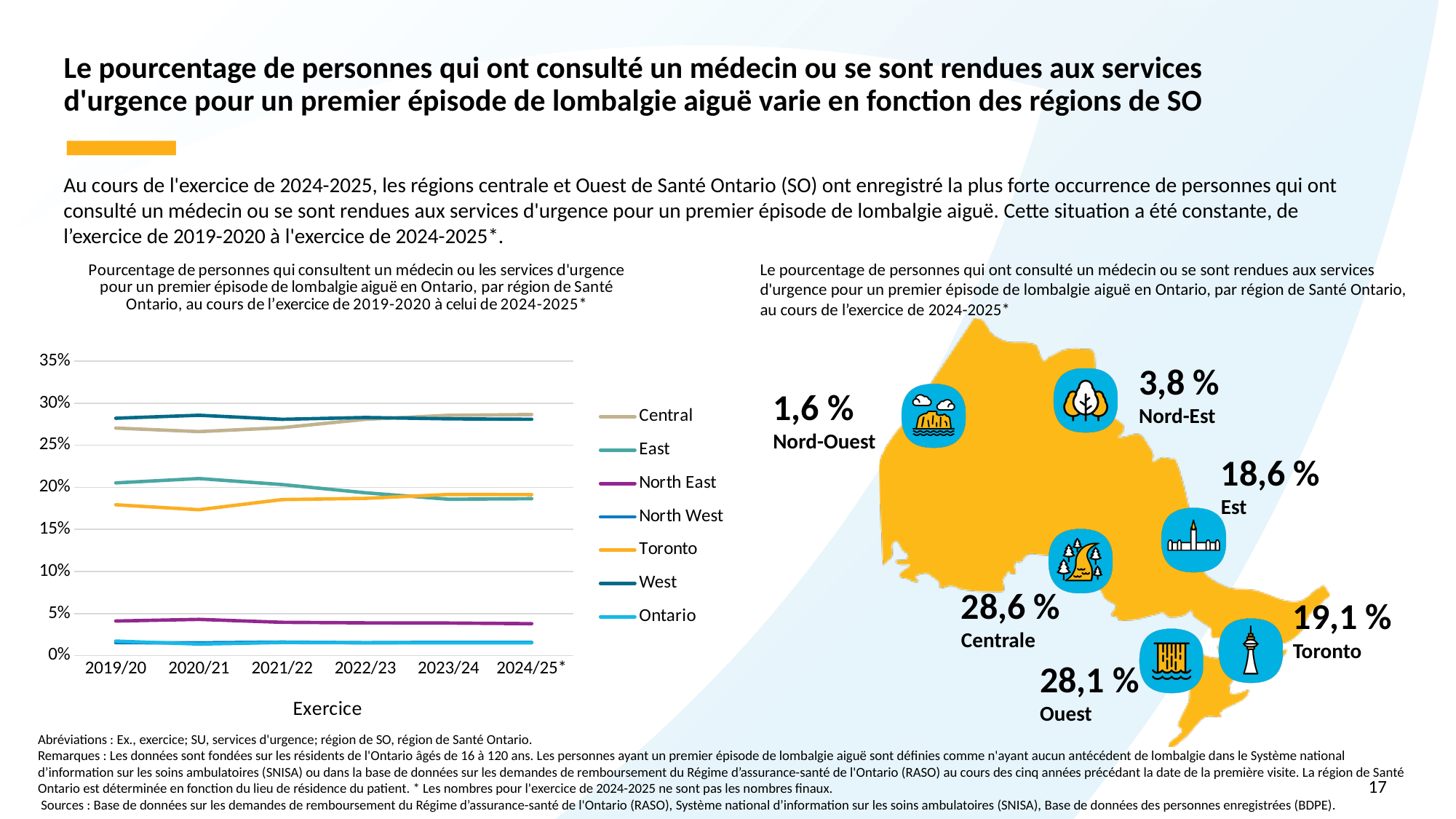
In the line chart, does the East series rise or fall from 2019/20 to 2024/25? fall On the map on the right, what is the percentage shown for Centrale? 28,6 % In the line chart, is the value for North East in 2024/25 greater or less than 5%? less In the line chart, is the value for Toronto in 2019/20 greater or less than 20%? less What is the label of the x axis of the line chart? Exercice How many series does the legend of the line chart list? 7 On the map on the right, what is the difference between the percentages for Centrale and Ouest? 0,5 % On the map on the right, which region has the lowest percentage? Nord-Ouest In the line chart, is the value for Central in 2019/20 greater or less than 25%? greater How many fiscal years are plotted along the x axis of the line chart? 6 What kind of chart is shown on the left of the slide? line chart In the line chart, which is larger in 2019/20, Central or East? Central